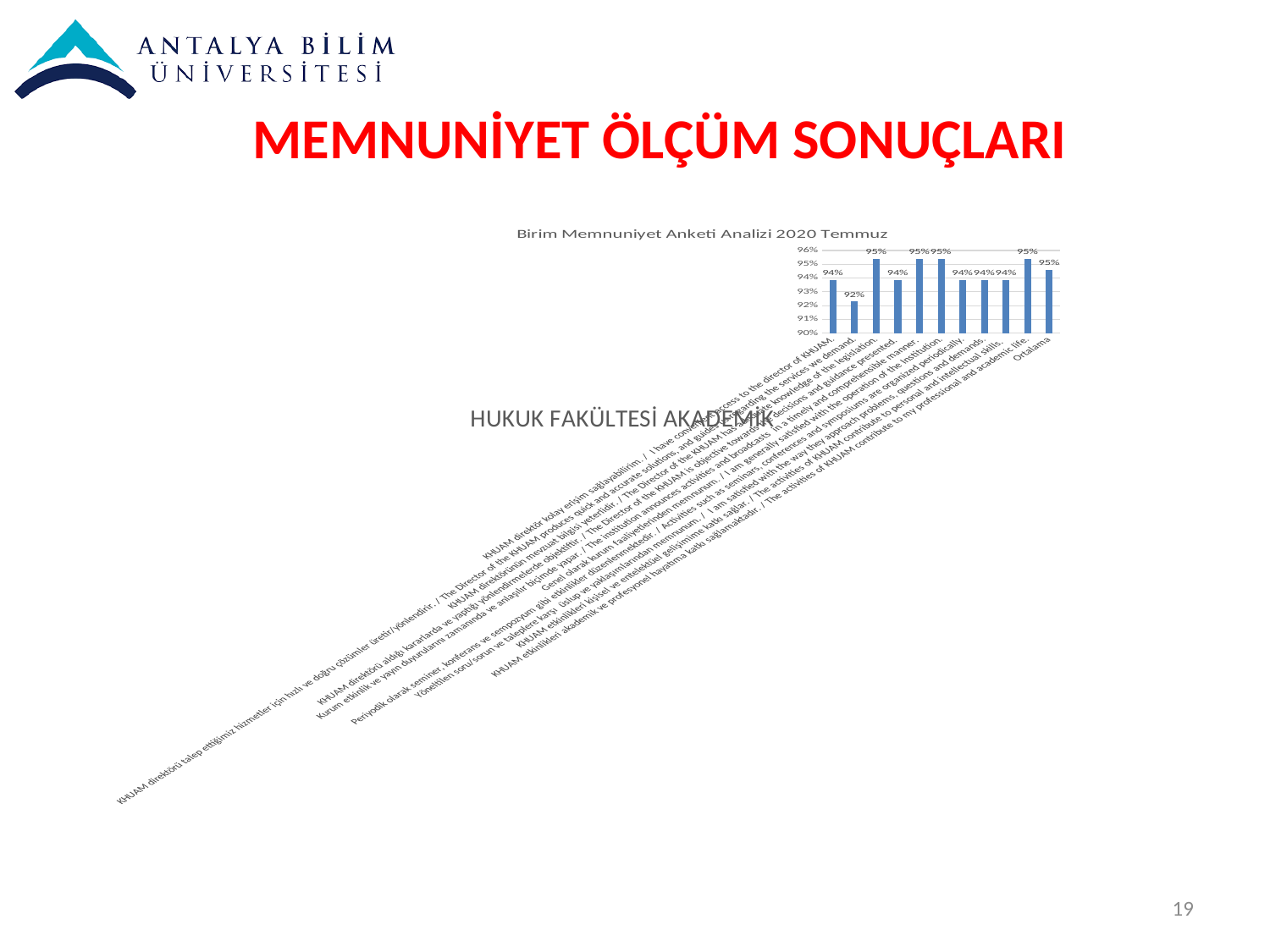
What is the value for the Ortalama category? 95% What is the title of the chart? Birim Memnuniyet Anketi Analizi 2020 Temmuz What kind of chart is shown on the slide? bar chart What is the value of the first bar on the left of the chart? 94% Is the lowest bar in the chart greater or less than 93%? less How many bars are plotted in the chart? 11 What is the difference between the Ortalama value and the lowest value in the chart? 3% Is the value for Ortalama greater or less than 94%? greater What is the lowest tick value shown on the vertical axis? 90% What is the lowest value shown in the chart? 92% Which is larger: the value for Ortalama or the value of the second bar from the left? Ortalama What is the value of the second bar from the left? 92%